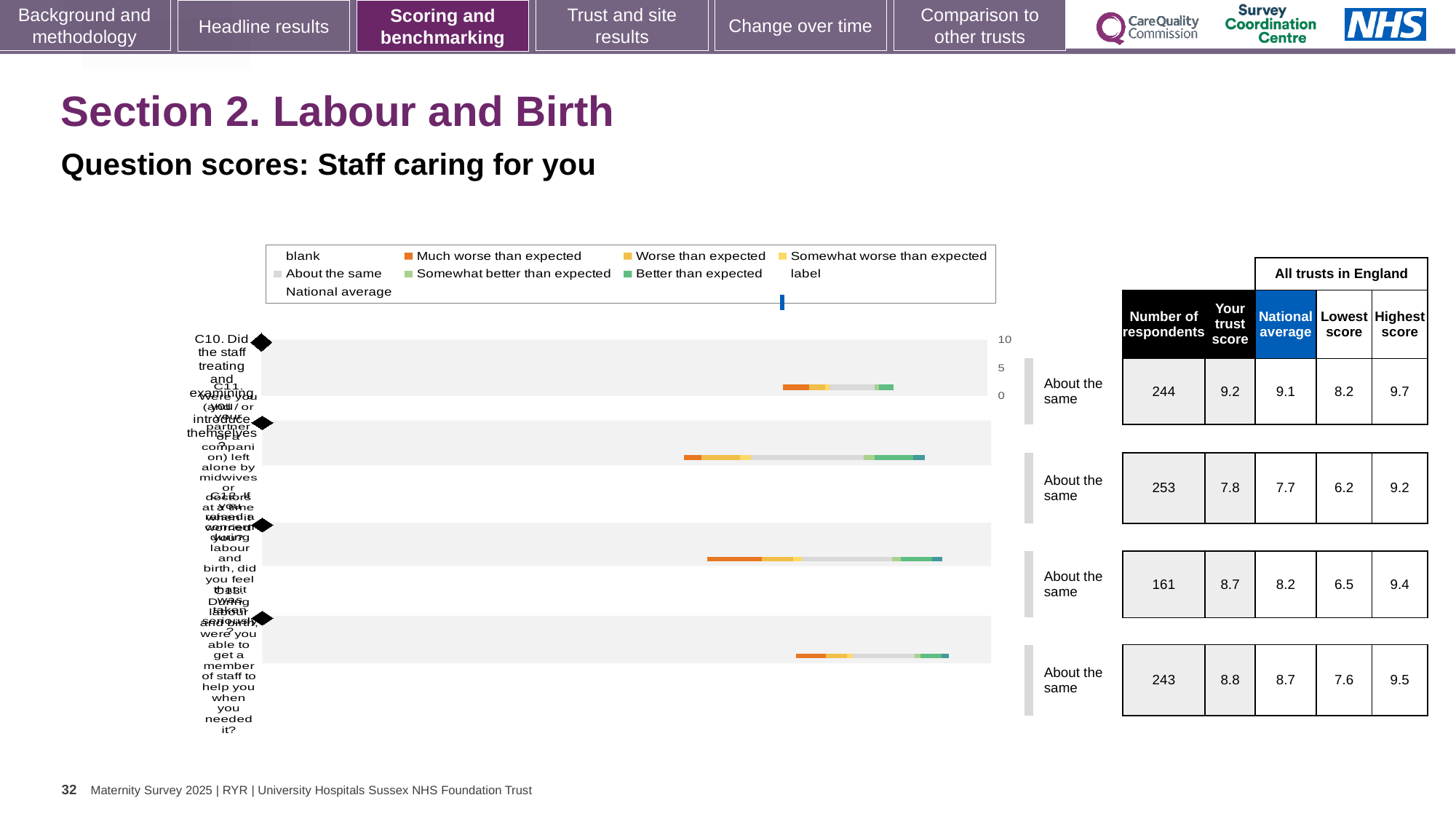
What is the trust score for the second row (C11)? 7.8 What kind of chart is shown on the slide? bar chart What benchmark label is shown next to every row of the chart? About the same What is the number of respondents for the first row (C10)? 244 In the chart legend, which colour represents 'Much worse than expected'? orange What is the national average for the third row (C12)? 8.2 What is the highest score across all trusts in England for the fourth row (C13)? 9.5 Which is larger, the trust score for the first row (C10) or the trust score for the second row (C11)? first row (C10), 9.2 Which row has the lowest number of respondents? third row (C12), 161 Which row has the highest number of respondents? second row (C11), 253 What is the difference between the trust score and the national average for the third row (C12)? 0.5 How many question rows (categories) are plotted in the chart? 4